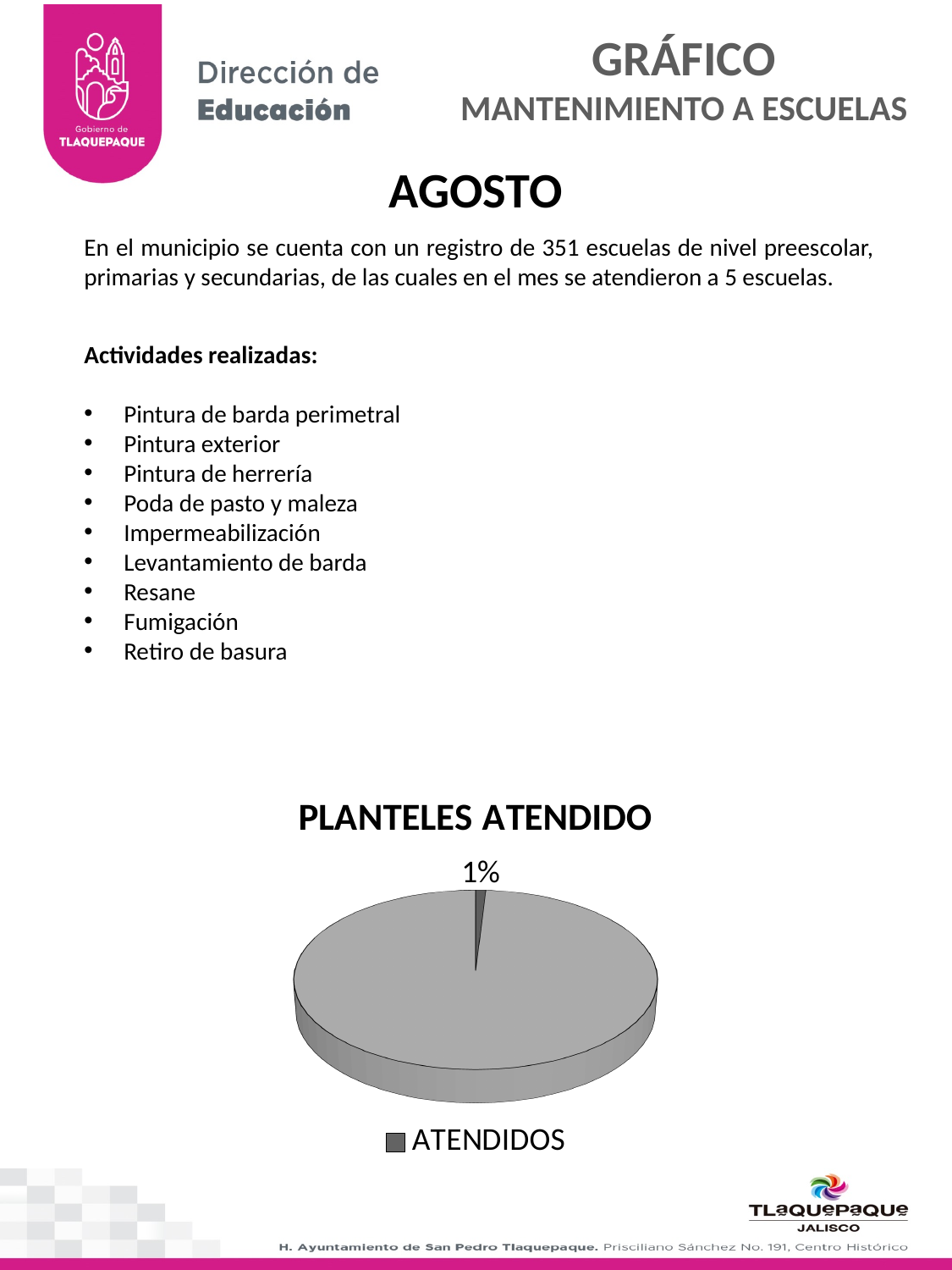
Is the share of the ATENDIDOS slice greater or less than 50%? less What kind of chart is shown under the heading PLANTELES ATENDIDO? pie chart What is the legend entry shown below the pie chart? ATENDIDOS What percentage label is printed on the small slice of the pie chart? 1% Is the ATENDIDOS slice the larger or the smaller slice of the pie chart? smaller What is the title of the chart on the slide? PLANTELES ATENDIDO How many entries does the legend of the pie chart list? 1 How many slices are visible in the pie chart? 2